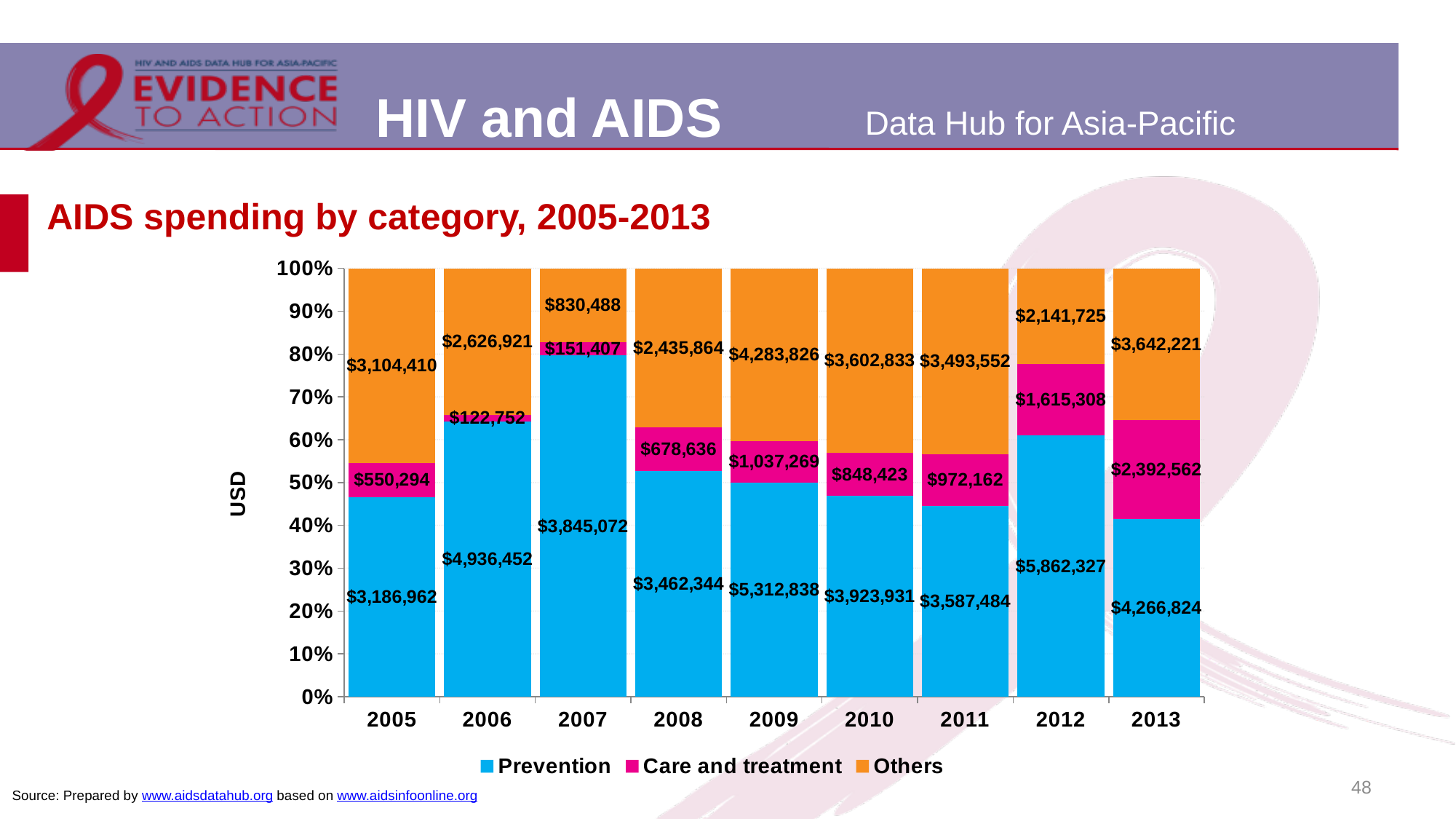
How many series does the legend list? 3 Which year had the lowest Care and treatment spending? 2006 Which was larger in 2005, Prevention spending or Others spending? Prevention What was the Care and treatment spending in 2006? $122,752 Which year had the lowest Others spending? 2007 What is the difference between Others and Care and treatment spending in 2013? $1,249,659 What was the Prevention spending in 2012? $5,862,327 How many years are shown on the x axis? 9 What is the total spending across all three categories in 2007? $4,826,967 What was the Others spending in 2009? $4,283,826 Which year had the highest Prevention spending? 2012